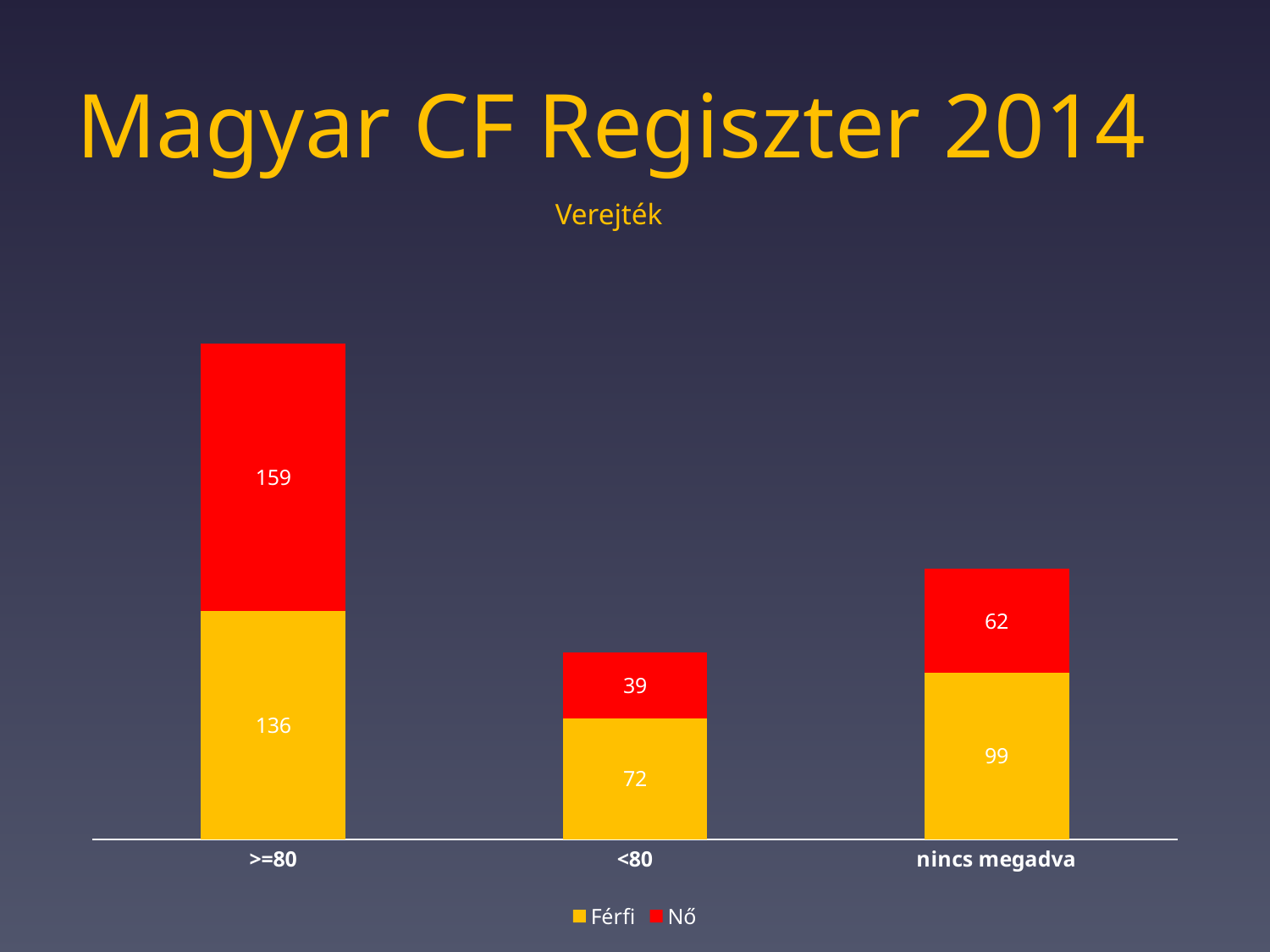
Which category has the highest Nő value? >=80 What is the total of the stacked bar for the <80 category? 111 How many series does the legend list? 2 Which category has the lowest Férfi value? <80 What is the Nő value for the <80 category? 39 What is the Férfi value for the >=80 category? 136 What is the Nő value for the nincs megadva category? 62 What is the difference between the Nő value and the Férfi value for the >=80 category? 23 What is the total of the stacked bar for the >=80 category? 295 Which is larger for the nincs megadva category, the Férfi value or the Nő value? Férfi What type of chart is shown on the slide? Stacked bar chart How many categories are shown on the x axis? 3